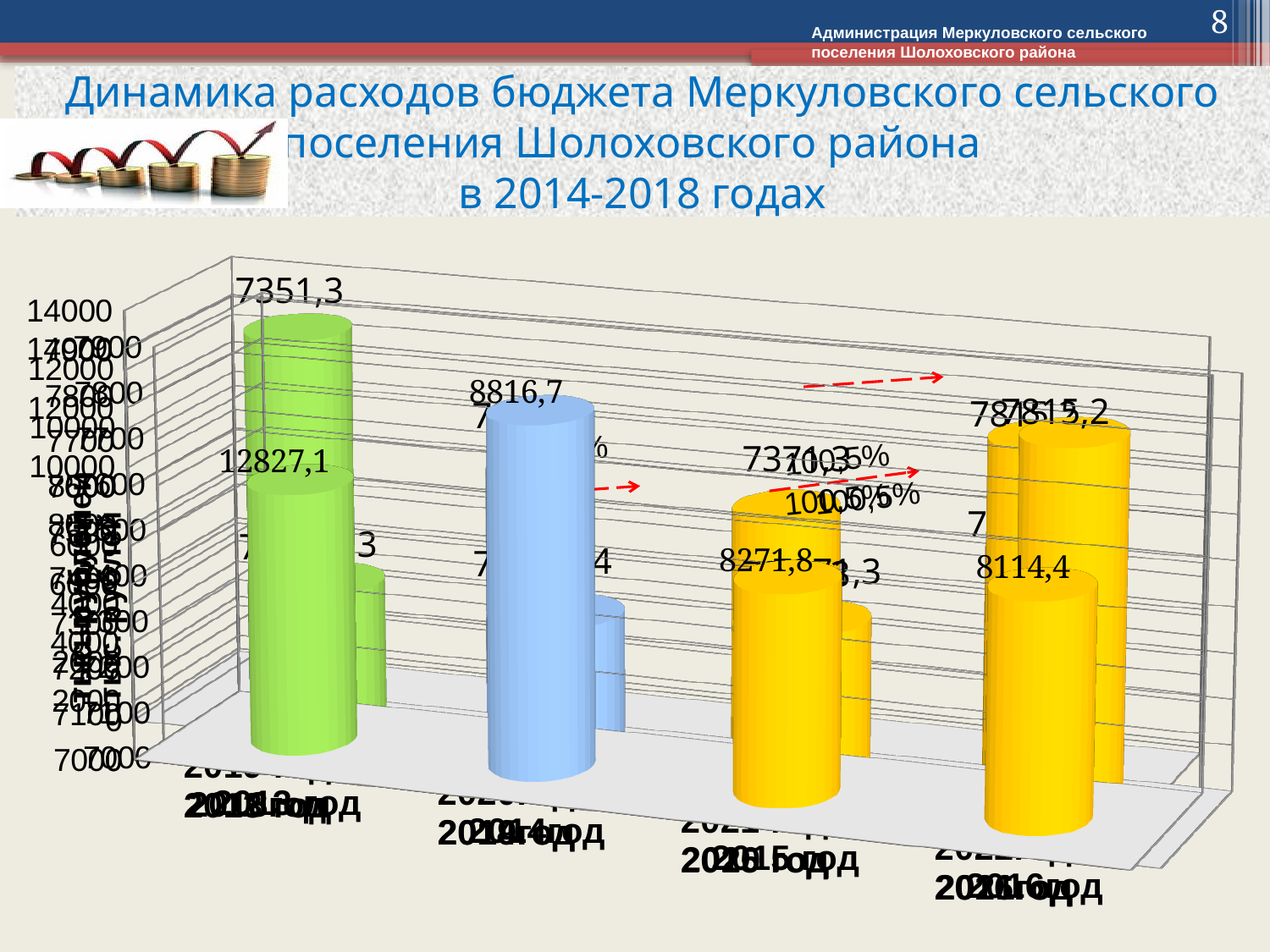
What value is printed above the tall blue cylinder in the front row of the chart? 8816,7 What value is printed above the front yellow cylinder at the far right of the chart? 8114,4 What value is printed above the tall green cylinder at the front left of the chart? 12827,1 What is the difference between the front blue cylinder value (8816,7) and the front yellow cylinder value third from the left (8271,8)? 544,9 What kind of chart is shown on the slide? bar chart Which is larger: the value on the front blue cylinder (8816,7) or the value on the front yellow cylinder third from the left (8271,8)? 8816,7 Which front-row cylinder has the highest printed value? the green one at the far left (12827,1) What value is printed above the front yellow cylinder third from the left? 8271,8 What is the title of the slide's chart? Динамика расходов бюджета Меркуловского сельского поселения Шолоховского района в 2014-2018 годах How many tall cylinders are in the front row of the chart? 4 Which front-row cylinder has the lowest printed value? the yellow one at the far right (8114,4) Do the values of the front-row cylinders rise or fall from left to right? fall